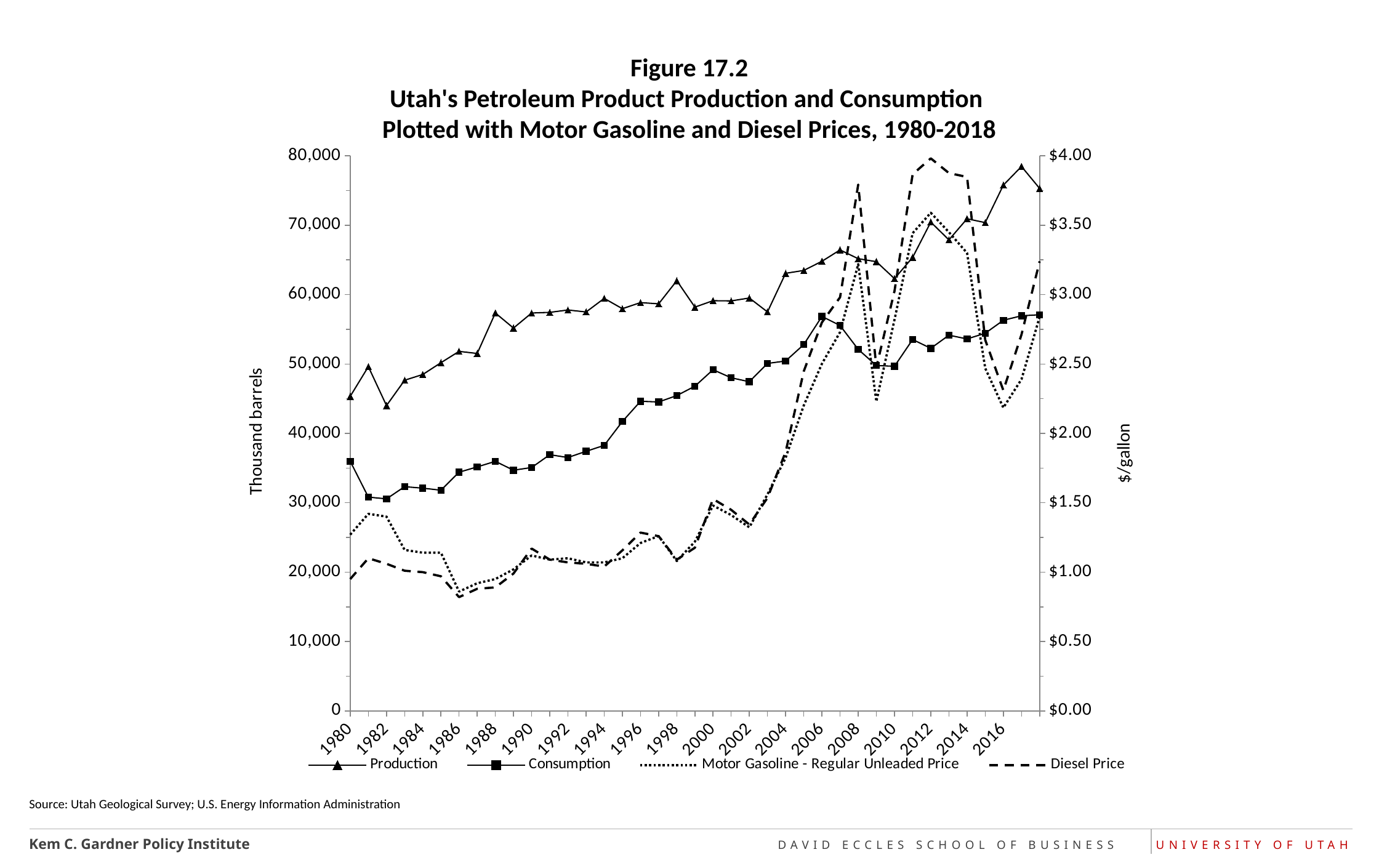
Is the value for Consumption in 1980 greater or less than 40,000? less Is the value for Production in 2017 greater or less than 70,000? greater How many series does the legend list? 4 Is the value for Production in 1980 greater or less than 40,000? greater In 2008, which is higher, the Diesel Price or the Motor Gasoline - Regular Unleaded Price? Diesel Price In 2000, which is larger, Production or Consumption? Production What is the label of the left vertical axis? Thousand barrels In which year does Production reach its highest value? 2017 What is the label of the right vertical axis? $/gallon What kind of chart is shown on the slide? Line chart